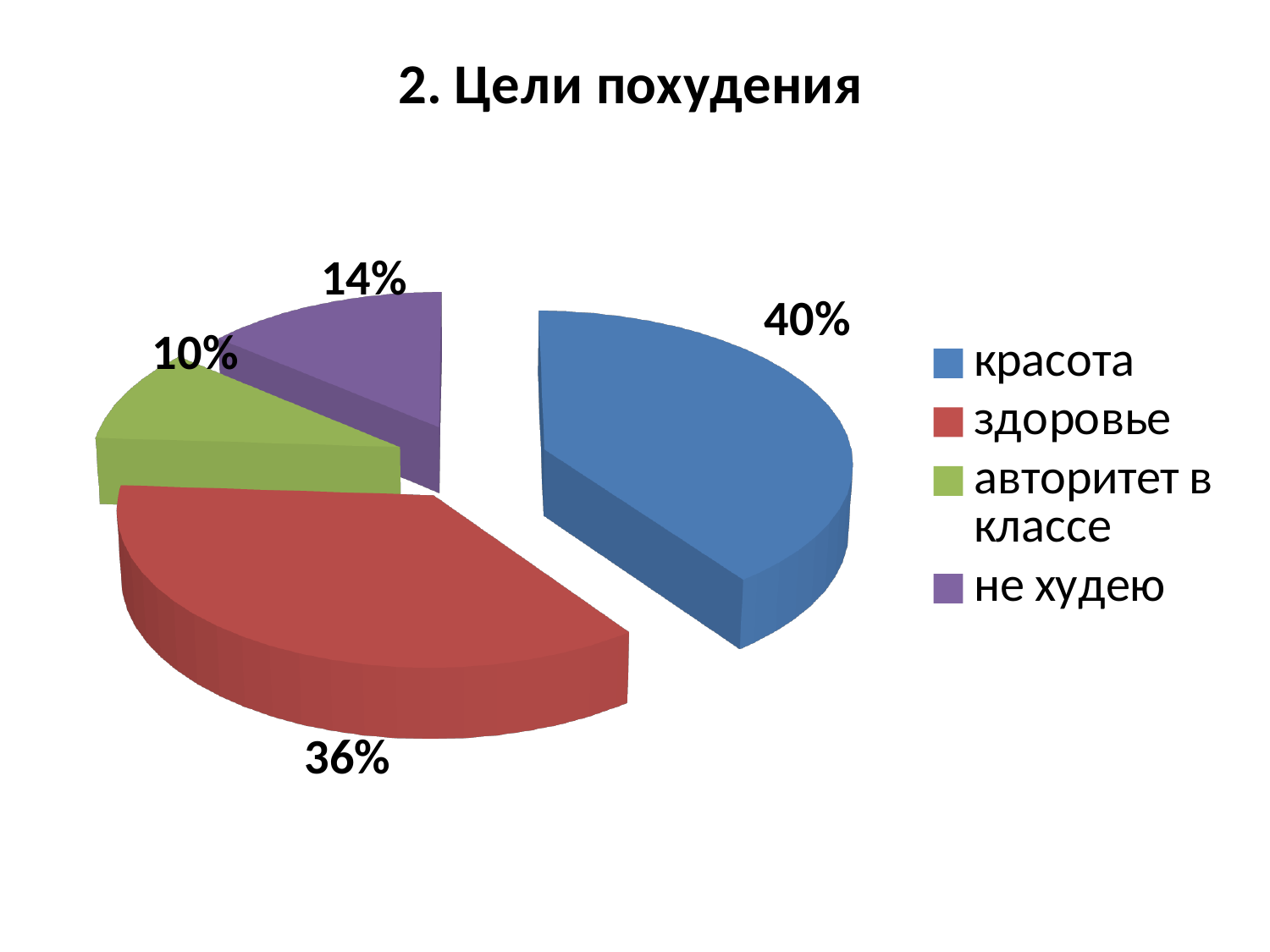
What share of the pie does здоровье have? 36% What share of the pie does не худею have? 14% What share of the pie does красота have? 40% Which is larger, the slice for здоровье or the slice for не худею? здоровье How many categories does the pie chart show? 4 What is the difference in percentage points between красота and здоровье? 4% What is the title of the chart? 2. Цели похудения Which category has the largest slice of the pie? красота Which category has the smallest slice of the pie? авторитет в классе What is the difference in percentage points between не худею and авторитет в классе? 4% What kind of chart is shown on the slide? pie chart